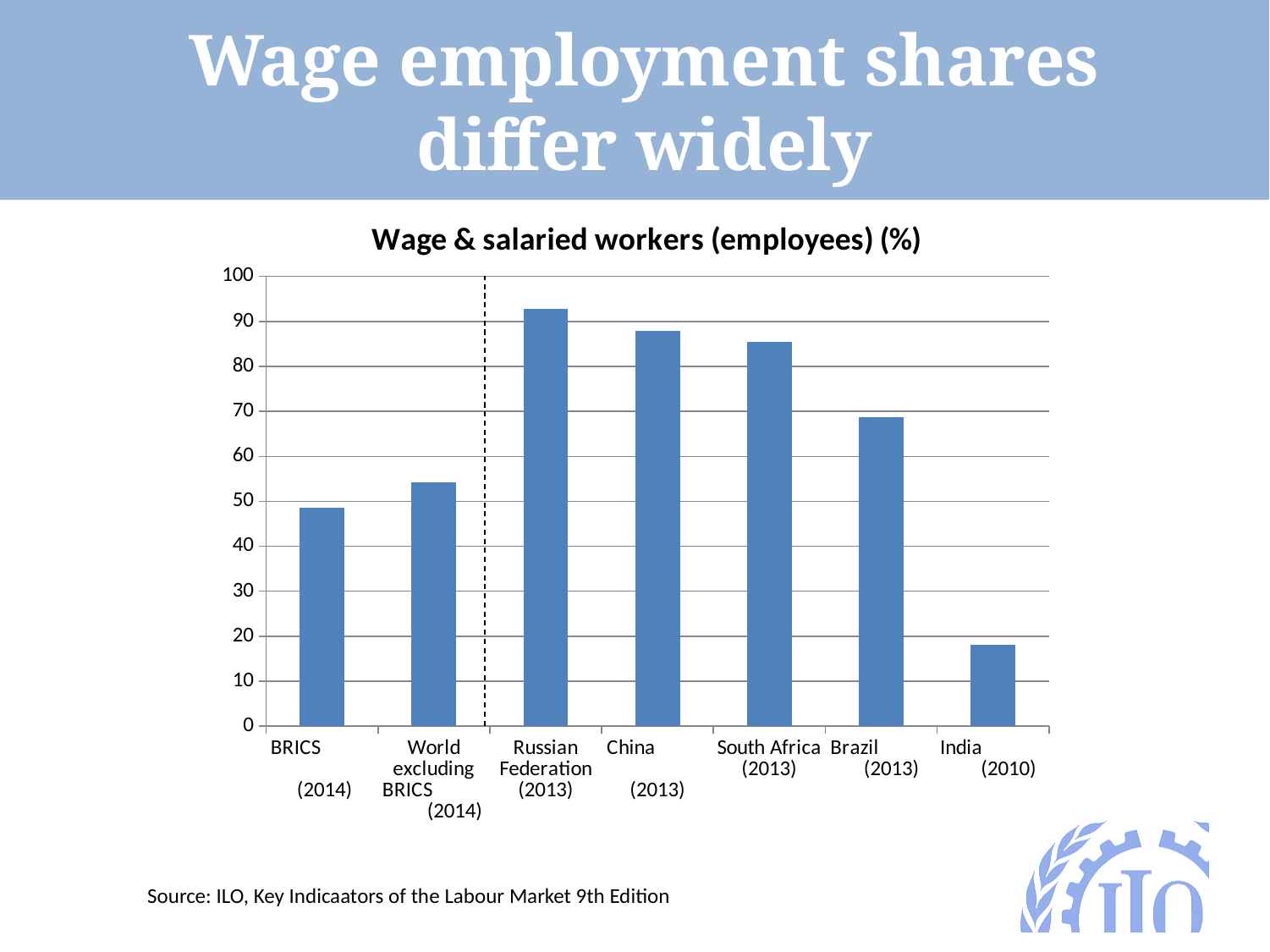
Is the value for Russian Federation (2013) greater or less than 90? greater Is the value for World excluding BRICS (2014) greater or less than 60? less Which is larger, the value for BRICS (2014) or the value for World excluding BRICS (2014)? World excluding BRICS (2014) Is the value for India (2010) greater or less than 20? less What type of chart is shown on the slide? bar chart Which category has the lowest share of wage & salaried workers? India (2010) Which is larger, the value for Russian Federation (2013) or the value for China (2013)? Russian Federation (2013) How many categories (bars) are shown in the chart? 7 Which category has the highest share of wage & salaried workers? Russian Federation (2013) What is the title of the chart? Wage & salaried workers (employees) (%)